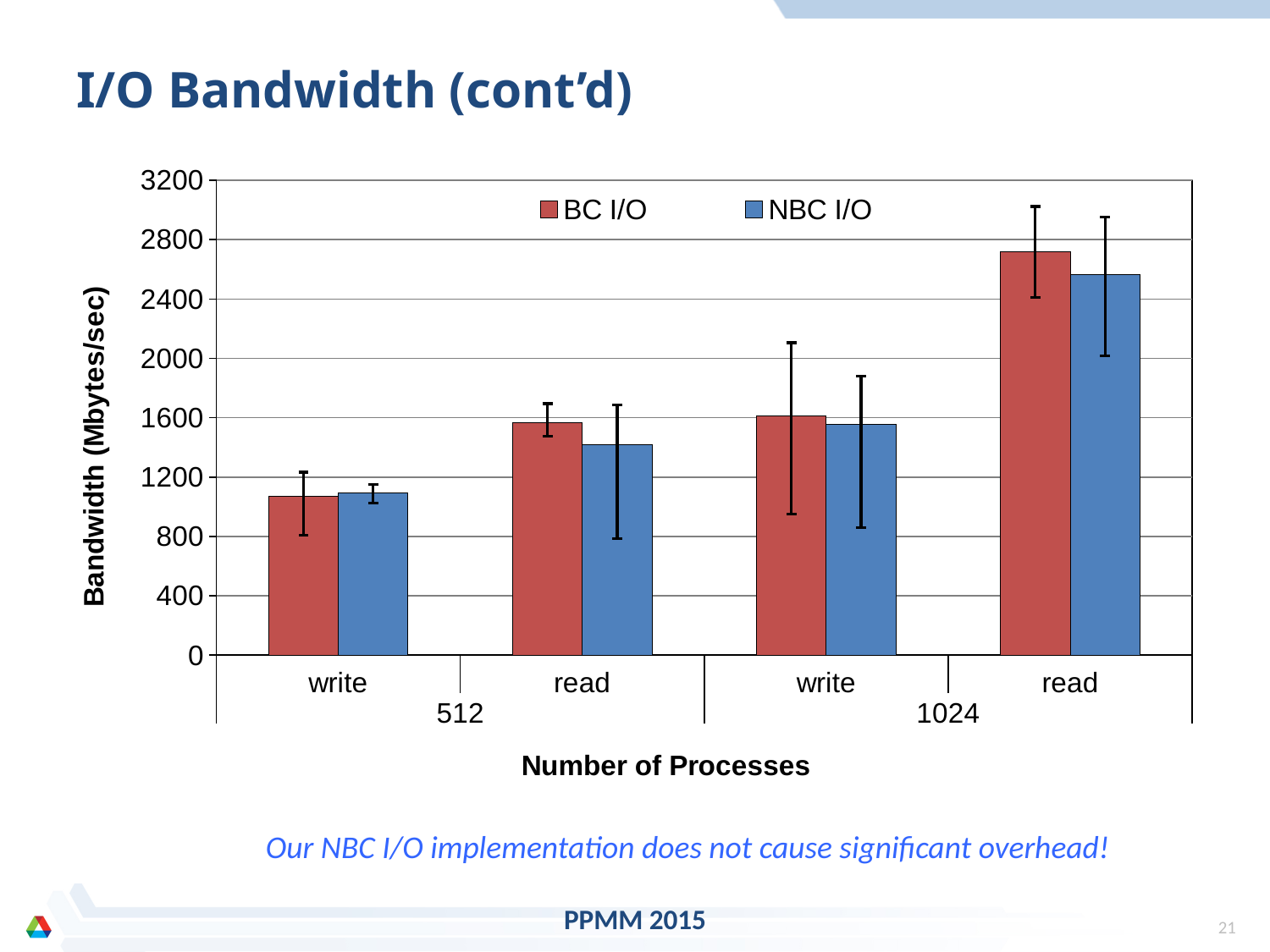
Is the BC I/O value for write at 512 processes greater or less than 1200? less What kind of chart is shown on the slide? bar chart How many bar groups (categories) are shown along the x axis? 4 For read at 512 processes, which is larger: BC I/O or NBC I/O? BC I/O Is the NBC I/O value for read at 512 processes greater or less than 1600? less Which category group has the lowest bars? write at 512 processes Is the BC I/O value for write at 1024 processes greater or less than 1200? greater What is the label of the y axis? Bandwidth (Mbytes/sec) For read at 1024 processes, which is larger: BC I/O or NBC I/O? BC I/O How many series does the legend list? 2 Which bar is the highest in the chart? BC I/O, read at 1024 processes